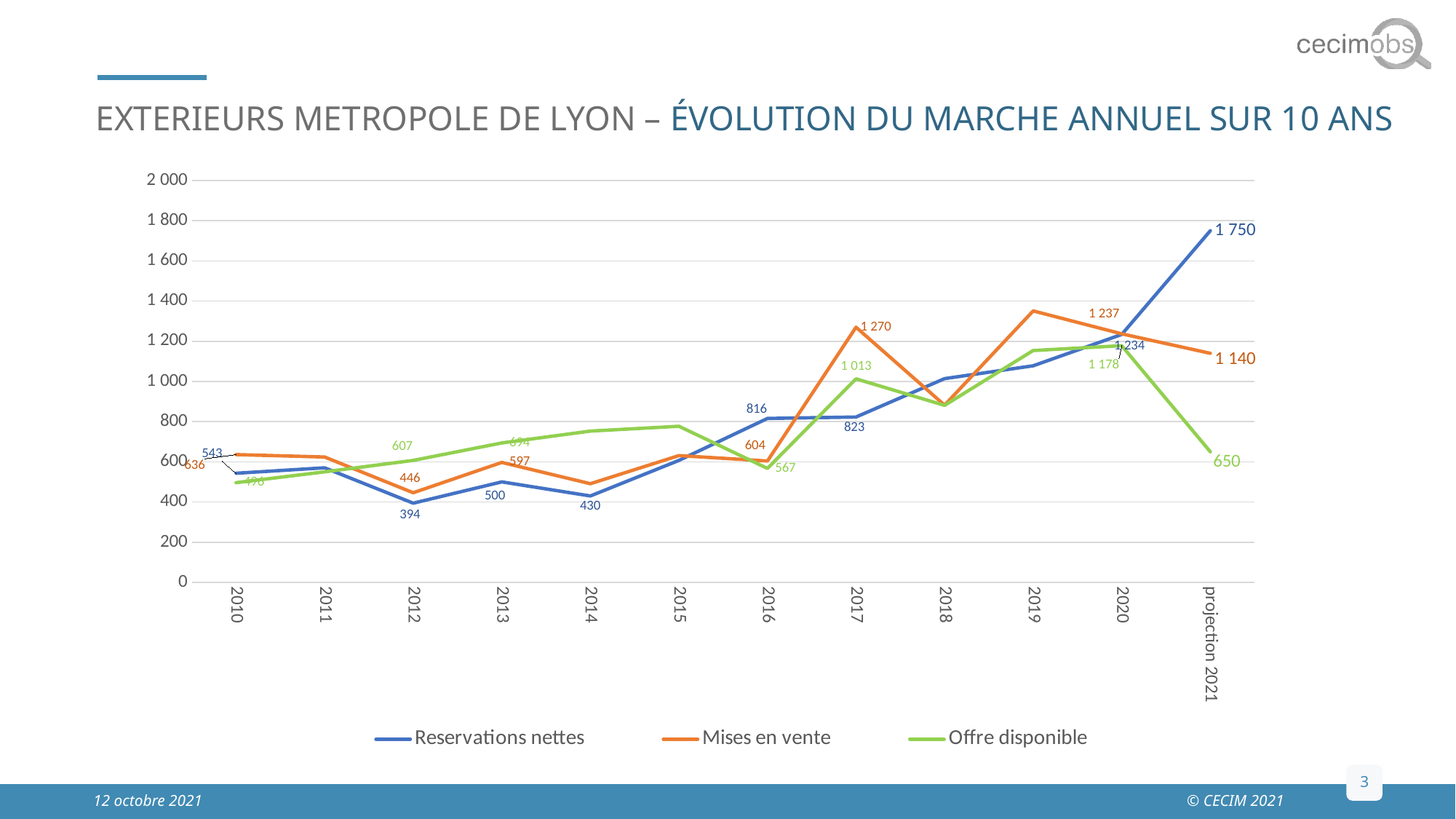
What is the value of Reservations nettes for projection 2021? 1 750 What is the value of Mises en vente in 2017? 1 270 In which year is Reservations nettes at its lowest? 2012 What is the difference between Reservations nettes in 2020 and in 2012? 840 How many points are plotted along the x axis for each series? 12 For projection 2021, which is larger: Reservations nettes or Mises en vente? Reservations nettes What is the value of Offre disponible for projection 2021? 650 Is the value of Offre disponible in 2015 greater or less than 600? greater How many series does the legend list? 3 What is the value of Offre disponible in 2020? 1 178 What is the difference between Mises en vente and Reservations nettes in 2017? 447 What kind of chart is shown on the slide? line chart